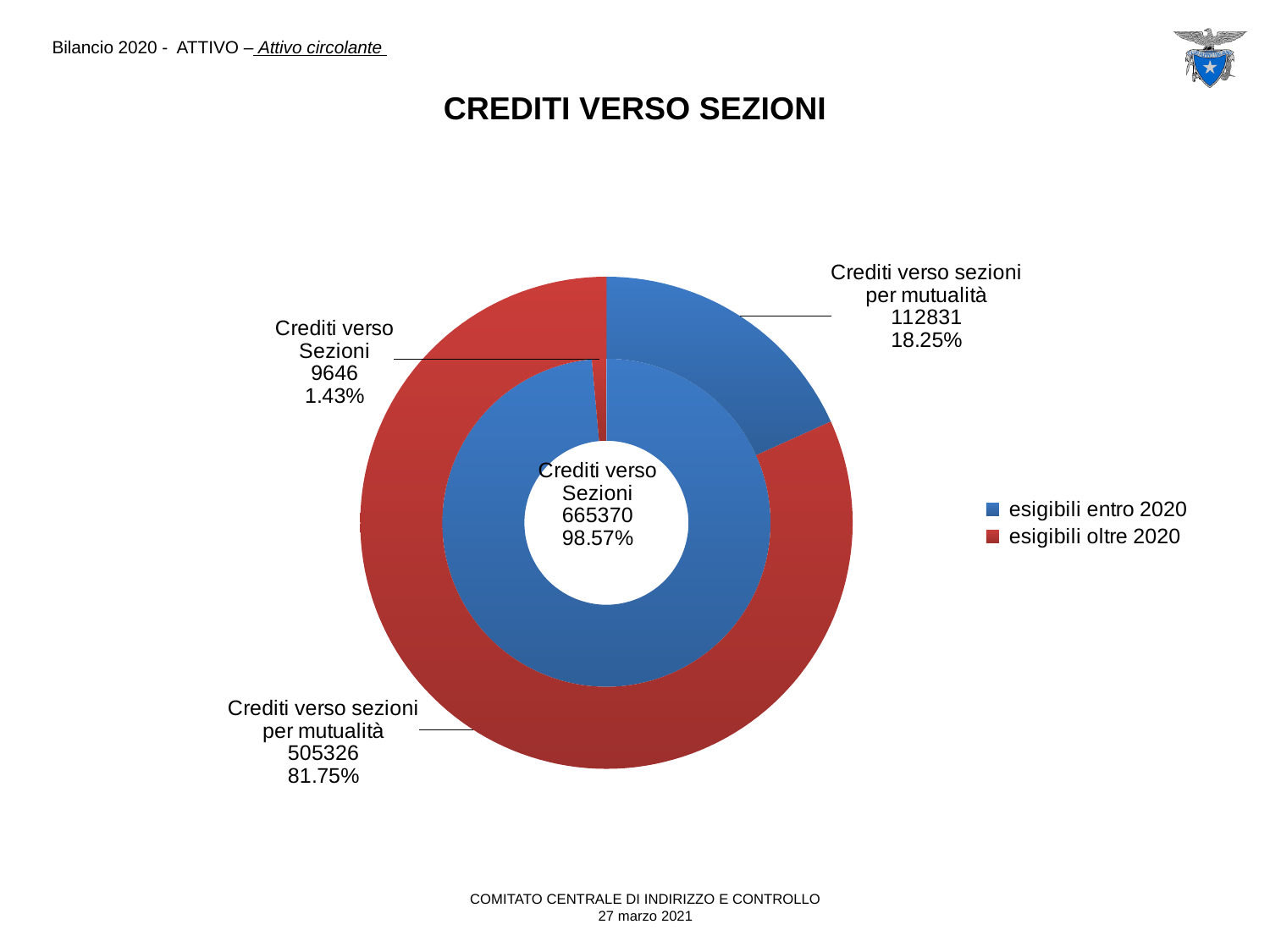
What is the title of the chart? CREDITI VERSO SEZIONI What is the difference between Crediti verso sezioni per mutualità esigibili oltre 2020 (505326) and esigibili entro 2020 (112831)? 392495 Which legend entry is shown in red? esigibili oltre 2020 How many series does the legend list? 2 What kind of chart is shown on the slide? doughnut chart What percentage share of the outer ring is Crediti verso sezioni per mutualità esigibili entro 2020? 18.25% What is the total of the inner ring (Crediti verso Sezioni), 665370 plus 9646? 675016 What is the value of Crediti verso Sezioni esigibili oltre 2020 (inner ring)? 9646 What percentage share of the inner ring is Crediti verso Sezioni esigibili oltre 2020? 1.43% What is the value of Crediti verso Sezioni esigibili entro 2020 (inner ring)? 665370 What is the value of Crediti verso sezioni per mutualità esigibili oltre 2020 (outer ring)? 505326 Which is larger in the outer ring: Crediti verso sezioni per mutualità esigibili entro 2020 or esigibili oltre 2020? esigibili oltre 2020